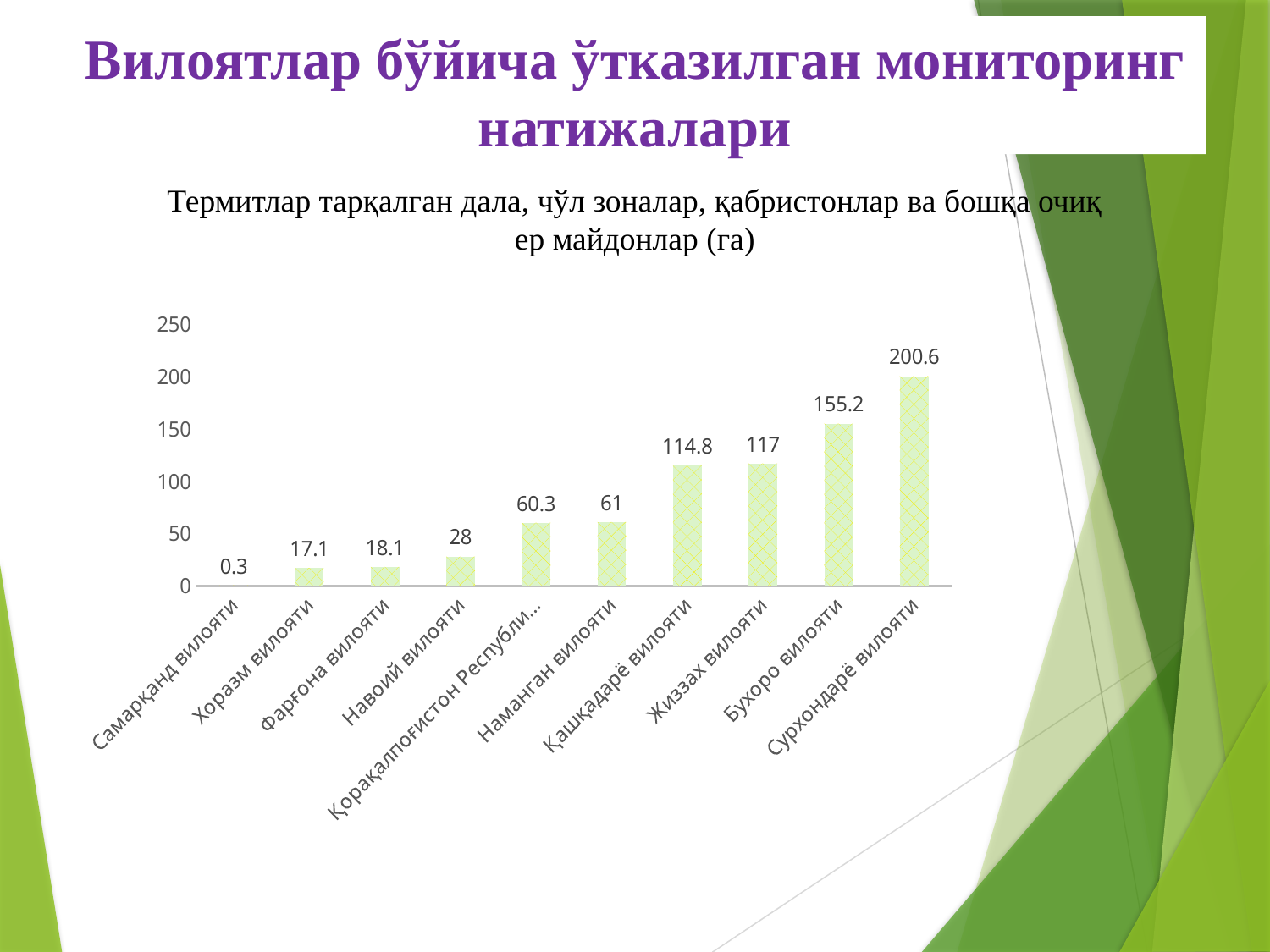
What is the difference between the values for Фарғона вилояти and Хоразм вилояти? 1 What is the value for Навоий вилояти? 28 Which is larger, the value for Бухоро вилояти or the value for Жиззах вилояти? Бухоро вилояти Which region has the lowest value? Самарқанд вилояти What is the value for Сурхондарё вилояти? 200.6 What is the difference between the values for Сурхондарё вилояти and Бухоро вилояти? 45.4 What type of chart is shown on the slide? bar chart Do the values rise or fall from left to right along the x axis? rise How many regions are shown on the chart? 10 What unit is given in parentheses in the chart title? га Which region has the highest value? Сурхондарё вилояти What is the value for Қашқадарё вилояти? 114.8